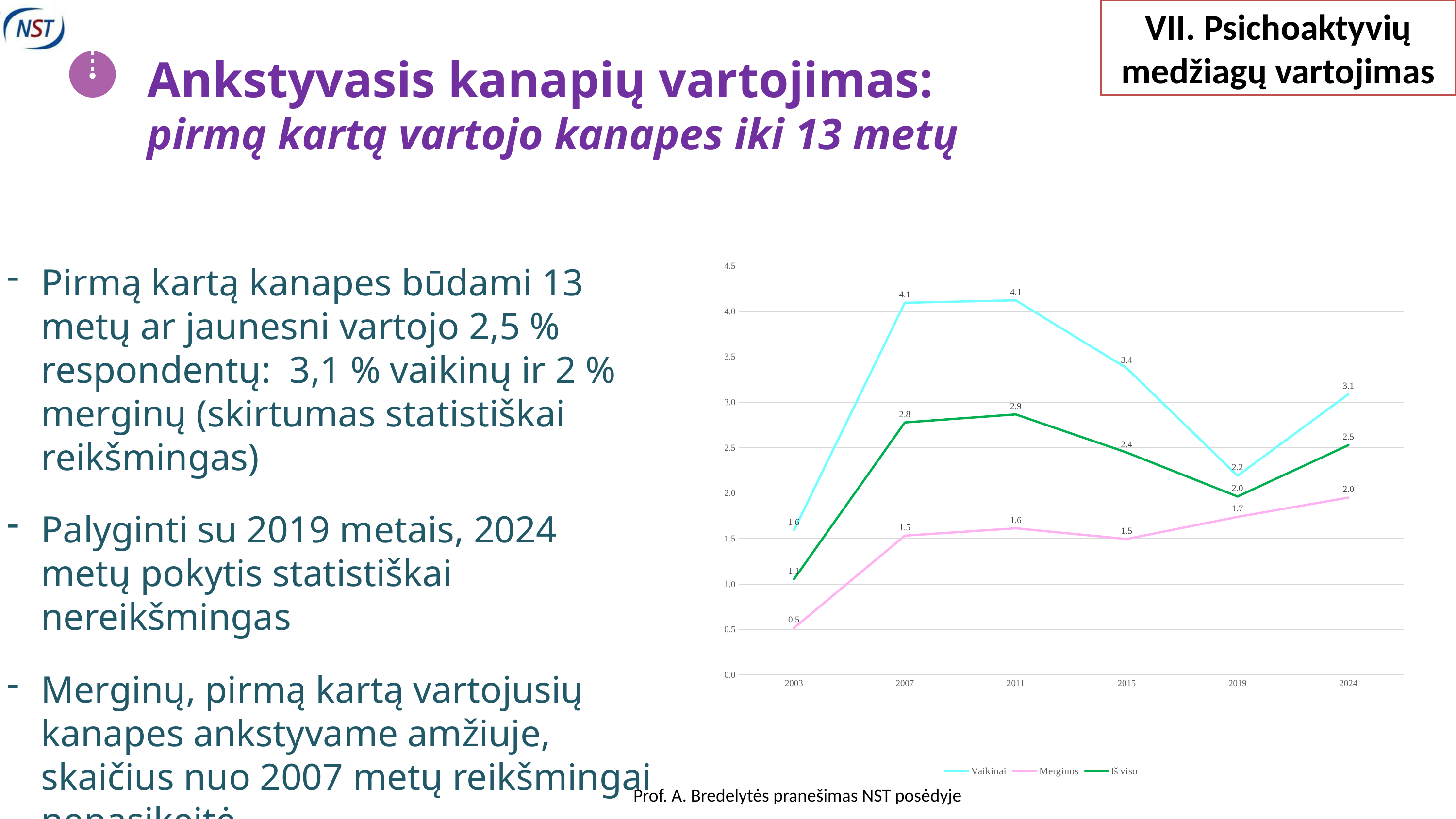
In which year is the Iš viso value highest? 2011 What type of chart is shown on the slide? line chart How many series does the chart legend list? 3 What is the value for Merginos in 2003? 0.5 Which series is drawn in green on the chart? Iš viso How many years are shown on the x axis of the chart? 6 What is the value for Iš viso in 2024? 2.5 What is the value for Vaikinai in 2015? 3.4 In which year is the Merginos value lowest? 2003 Which is larger in 2019: the Vaikinai value or the Iš viso value? Vaikinai Does the Vaikinai line rise or fall between 2011 and 2019? fall What is the difference between the Vaikinai and Merginos values in 2024? 1.1